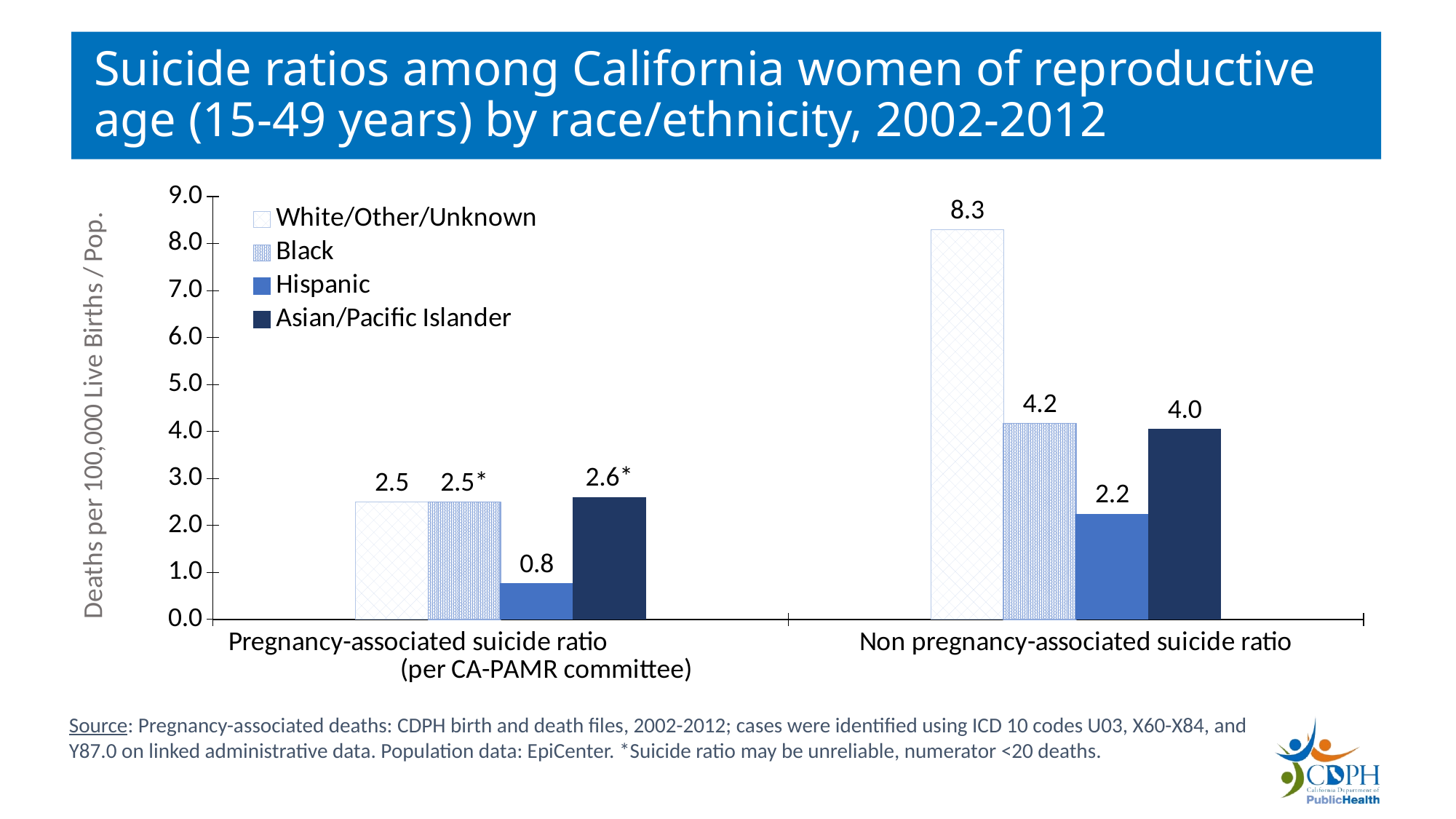
Which race/ethnicity group has the highest non pregnancy-associated suicide ratio? White/Other/Unknown How many categories are shown on the x axis? 2 What kind of chart is shown on the slide? Bar chart What is the difference between the non pregnancy-associated suicide ratio for Black women and for Hispanic women? 2.0 What is the pregnancy-associated suicide ratio for Hispanic women? 0.8 What is the non pregnancy-associated suicide ratio for Asian/Pacific Islander women? 4.0 How many series does the legend list? 4 Which race/ethnicity group has the lowest pregnancy-associated suicide ratio? Hispanic What is the non pregnancy-associated suicide ratio for White/Other/Unknown women? 8.3 Which is larger: the non pregnancy-associated suicide ratio for Black women or for Asian/Pacific Islander women? Black What is the label of the y axis? Deaths per 100,000 Live Births / Pop. Is the non pregnancy-associated suicide ratio for White/Other/Unknown women greater or less than 8.0? greater